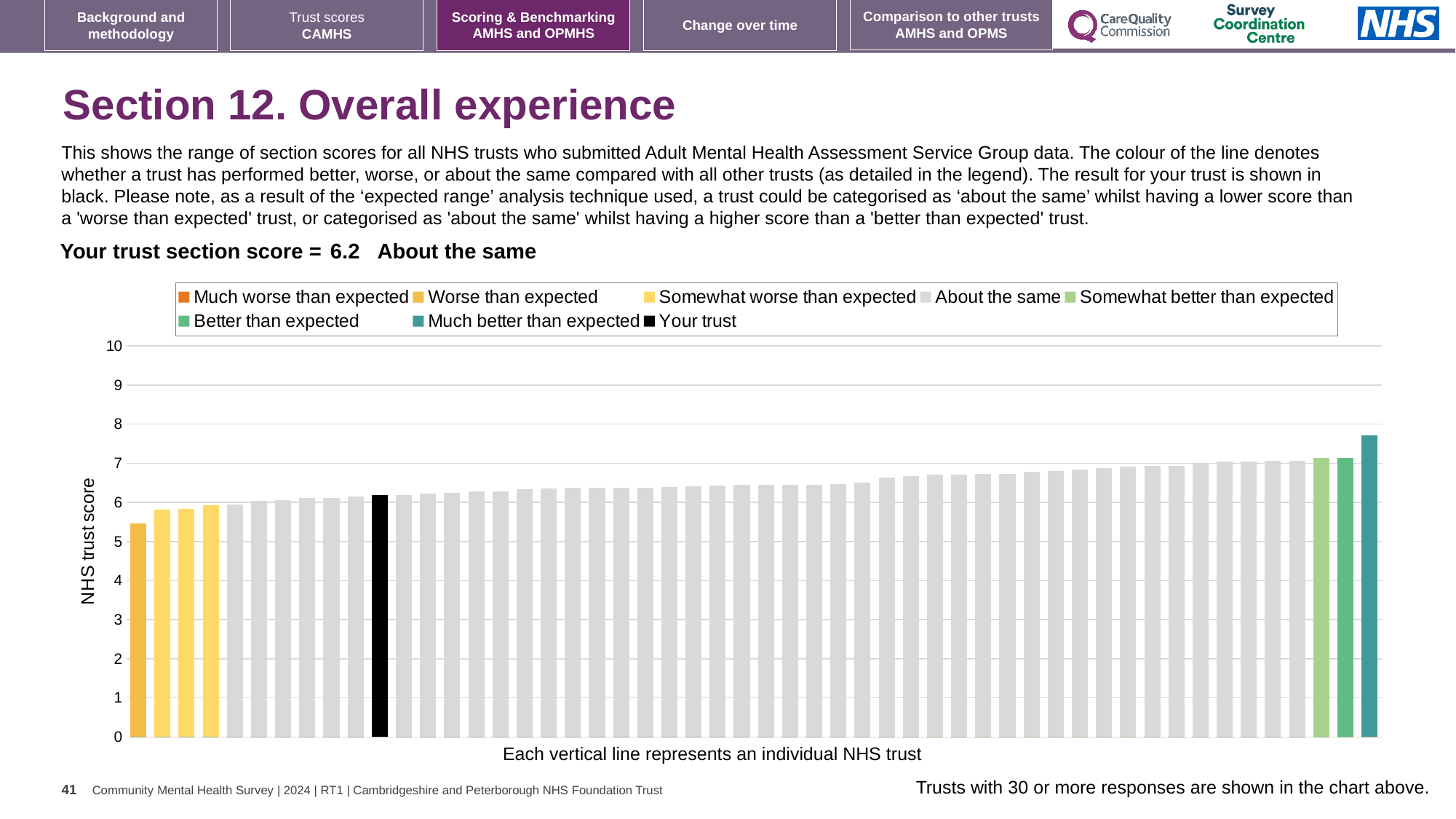
Is the value of the tallest bar (far right) greater or less than 7? greater What is the label on the vertical axis of the chart? NHS trust score Is the value of the black 'Your trust' bar greater or less than 7? less How many entries does the chart legend list? 8 Do the bar values rise or fall from left to right along the x axis? rise What is the highest tick value shown on the vertical axis? 10 Which legend category does the tallest bar belong to? Much better than expected Is the value of the leftmost bar greater or less than 6? less What kind of chart is shown on the slide? bar chart What colour is the bar representing your trust? black Which is larger: the value of the black 'Your trust' bar or the value of the leftmost bar? Your trust What is your trust's section score shown on the slide? 6.2